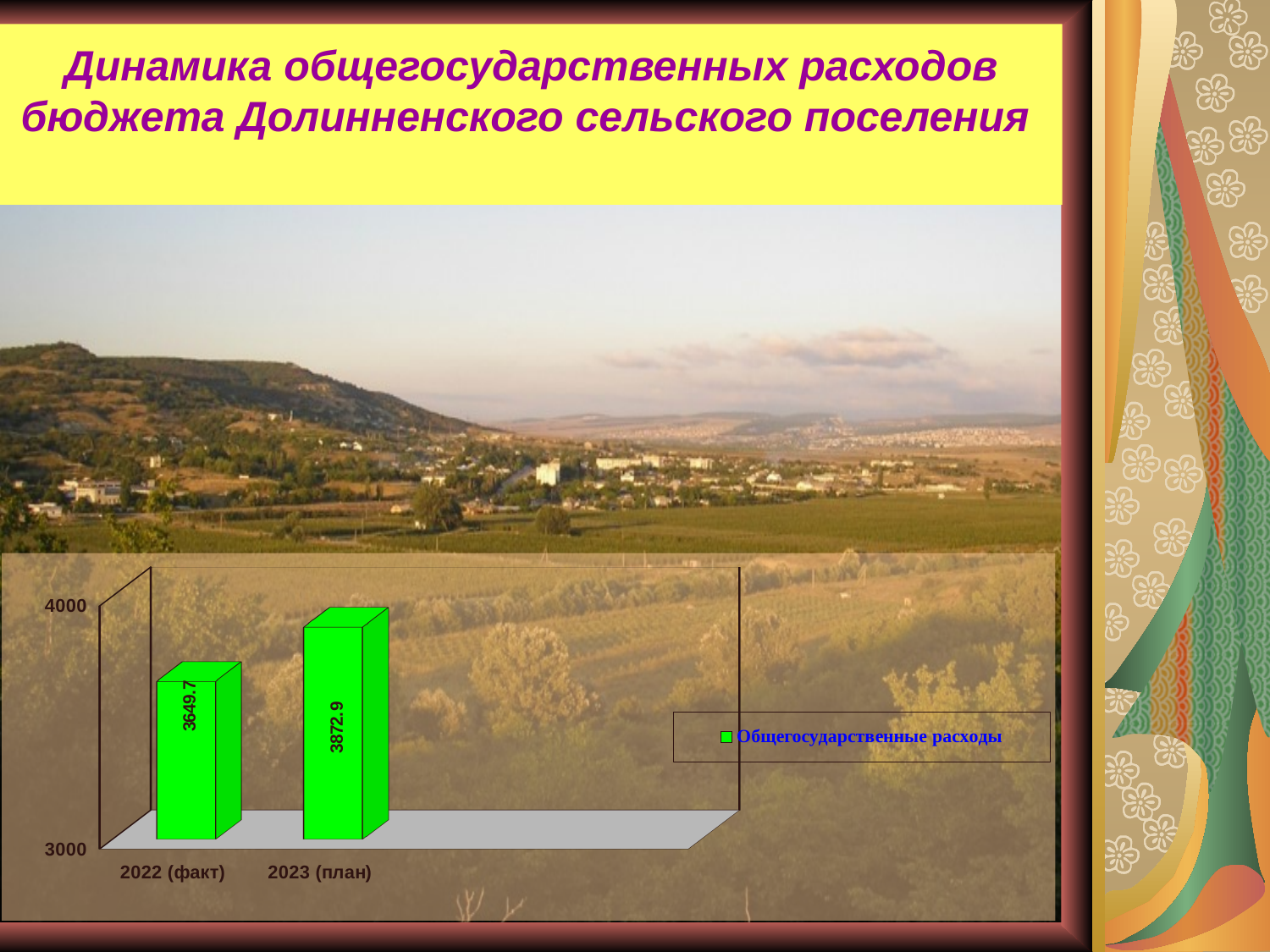
What is the value for 2022 (факт)? 3649.7 What kind of chart is shown on the slide? bar chart Which category has the highest value? 2023 (план) What is the value for 2023 (план)? 3872.9 Is the value for 2022 (факт) greater or less than 3000? greater Is the value for 2023 (план) greater or less than 4000? less What is the difference between the values for 2023 (план) and 2022 (факт)? 223.2 How many series does the legend list? 1 Which category has the lowest value? 2022 (факт) How many categories are shown on the x axis? 2 Which is larger, the value for 2022 (факт) or the value for 2023 (план)? 2023 (план) What series name is shown in the legend? Общегосударственные расходы